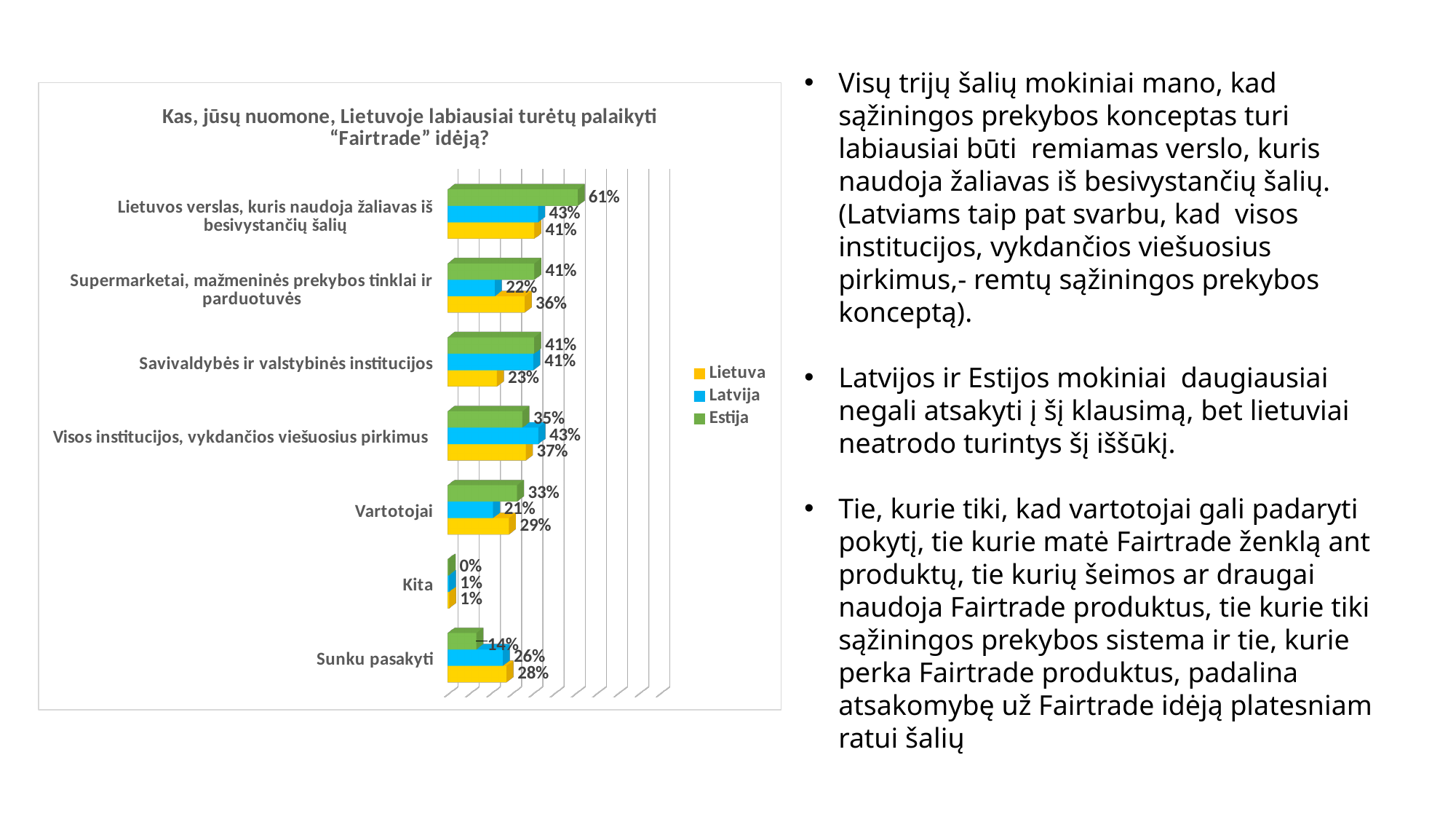
How many series does the legend list? 3 What is the value for Estija in the category "Lietuvos verslas, kuris naudoja žaliavas iš besivystančių šalių"? 61% How many categories are shown on the chart? 7 What is the value for Lietuva in the category "Sunku pasakyti"? 28% What is the value for Lietuva in the category "Savivaldybės ir valstybinės institucijos"? 23% Which category has the highest value for Estija? Lietuvos verslas, kuris naudoja žaliavas iš besivystančių šalių What kind of chart is shown on the slide? bar chart Which category has the lowest value for Latvija? Kita For "Visos institucijos, vykdančios viešuosius pirkimus", which is larger: the value for Latvija or the value for Estija? Latvija Which colour represents Latvija in the chart? blue What is the value for Latvija in the category "Supermarketai, mažmeninės prekybos tinklai ir parduotuvės"? 22% What is the difference between the Estija and Lietuva values for "Lietuvos verslas, kuris naudoja žaliavas iš besivystančių šalių"? 20%